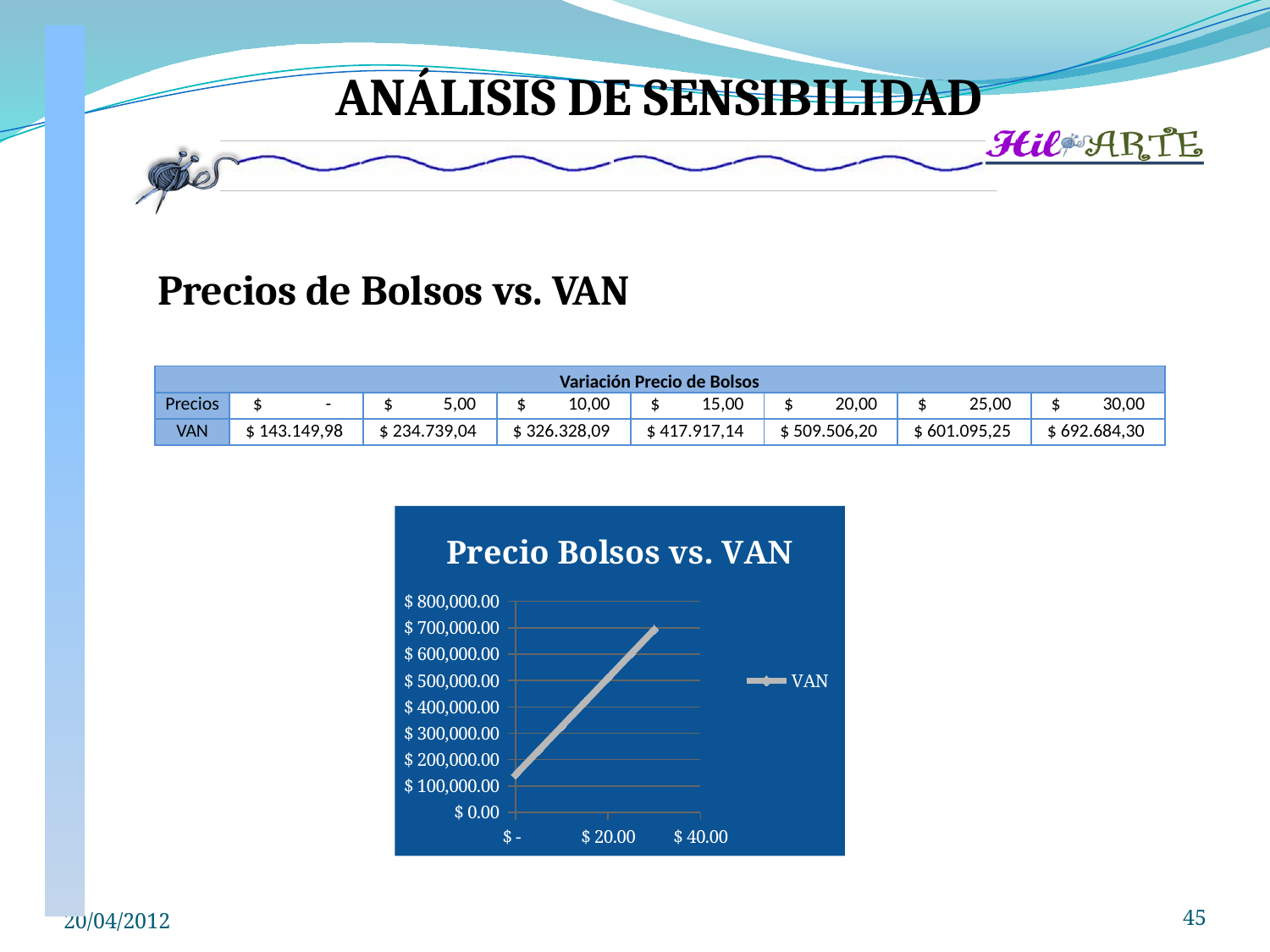
What is the name of the series shown in the legend of the "Precio Bolsos vs. VAN" chart? VAN What kind of chart is "Precio Bolsos vs. VAN"? line chart In the "Precio Bolsos vs. VAN" chart, is the highest VAN value plotted greater or less than $ 600,000.00? greater What is the title of the chart on the slide? Precio Bolsos vs. VAN How many price points are listed in the "Variación Precio de Bolsos" table? 7 According to the table above the chart, what is the VAN when the price is $ 15,00? $ 417.917,14 According to the table above the chart, what is the VAN when the price is $ 30,00? $ 692.684,30 How many series does the legend of the "Precio Bolsos vs. VAN" chart list? 1 According to the table above the chart, which price gives the lowest VAN? $ - In the "Precio Bolsos vs. VAN" chart, does the VAN rise or fall as the price increases along the x axis? rise In the "Precio Bolsos vs. VAN" chart, is the VAN at a price of $ - greater or less than $ 200,000.00? less In the "Precio Bolsos vs. VAN" chart, is the VAN at a price of $ 20.00 greater or less than $ 400,000.00? greater